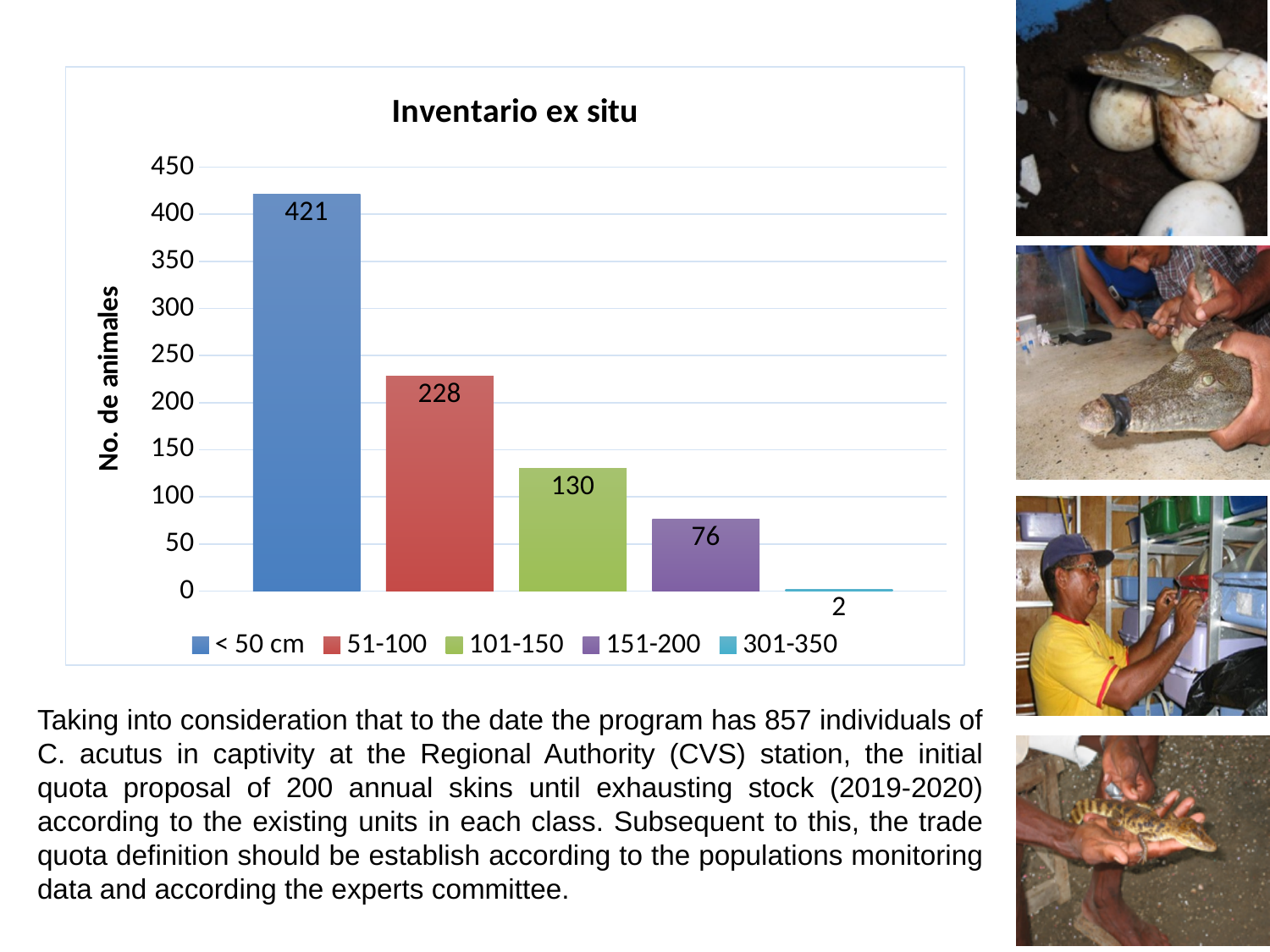
Which is larger, the value for 101-150 or the value for 151-200? 101-150 What is the value for the 101-150 category? 130 What is the value for the 301-350 category? 2 Do the values rise or fall from left to right across the categories? Fall What is the value for the 51-100 category? 228 What is the title of the chart? Inventario ex situ What is the difference between the < 50 cm and 51-100 values? 193 What is the value for the < 50 cm category in the Inventario ex situ chart? 421 How many categories are shown in the chart? 5 What kind of chart is shown on the slide? Bar chart Which category has the highest number of animals? < 50 cm Which category has the lowest number of animals? 301-350